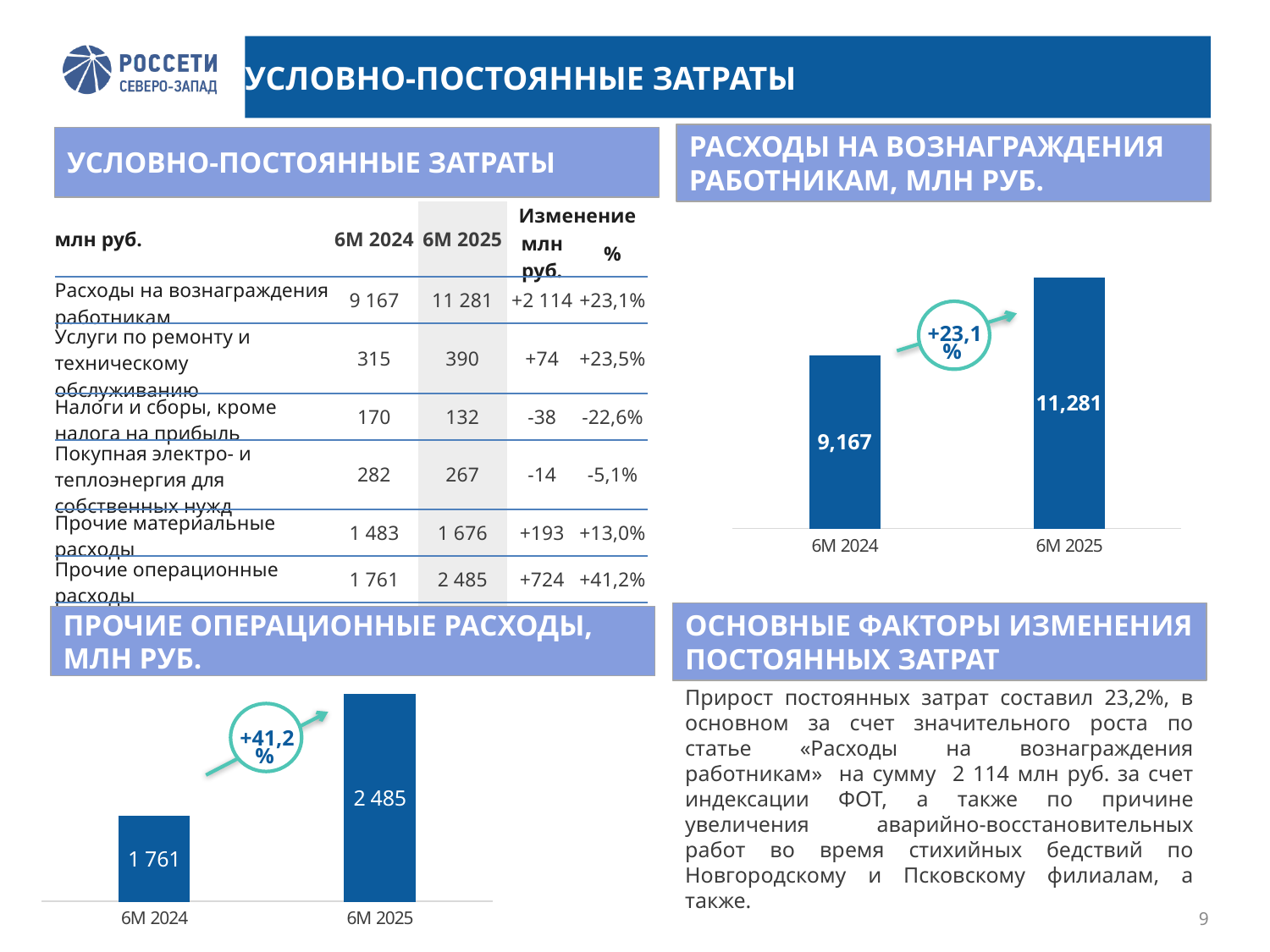
In the chart titled 'ПРОЧИЕ ОПЕРАЦИОННЫЕ РАСХОДЫ, МЛН РУБ.', what is the difference between the 6M 2025 and 6M 2024 values? 724 In the chart titled 'ПРОЧИЕ ОПЕРАЦИОННЫЕ РАСХОДЫ, МЛН РУБ.', what percentage change is shown between 6M 2024 and 6M 2025? +41,2% In the chart titled 'ПРОЧИЕ ОПЕРАЦИОННЫЕ РАСХОДЫ, МЛН РУБ.', which period has the lower value? 6M 2024 In the chart titled 'ПРОЧИЕ ОПЕРАЦИОННЫЕ РАСХОДЫ, МЛН РУБ.', what is the value for 6M 2024? 1 761 In the chart titled 'РАСХОДЫ НА ВОЗНАГРАЖДЕНИЯ РАБОТНИКАМ, МЛН РУБ.', what percentage change is shown between 6M 2024 and 6M 2025? +23,1% In the chart titled 'РАСХОДЫ НА ВОЗНАГРАЖДЕНИЯ РАБОТНИКАМ, МЛН РУБ.', what is the difference between the 6M 2025 and 6M 2024 values? 2,114 In the chart titled 'РАСХОДЫ НА ВОЗНАГРАЖДЕНИЯ РАБОТНИКАМ, МЛН РУБ.', which period has the higher value? 6M 2025 In the chart titled 'РАСХОДЫ НА ВОЗНАГРАЖДЕНИЯ РАБОТНИКАМ, МЛН РУБ.', what is the value for 6M 2024? 9,167 In the chart titled 'РАСХОДЫ НА ВОЗНАГРАЖДЕНИЯ РАБОТНИКАМ, МЛН РУБ.', what is the value for 6M 2025? 11,281 What kind of chart is the chart titled 'ПРОЧИЕ ОПЕРАЦИОННЫЕ РАСХОДЫ, МЛН РУБ.'? bar chart In the chart titled 'РАСХОДЫ НА ВОЗНАГРАЖДЕНИЯ РАБОТНИКАМ, МЛН РУБ.', how many bars are plotted? 2 In the chart titled 'ПРОЧИЕ ОПЕРАЦИОННЫЕ РАСХОДЫ, МЛН РУБ.', what is the value for 6M 2025? 2 485